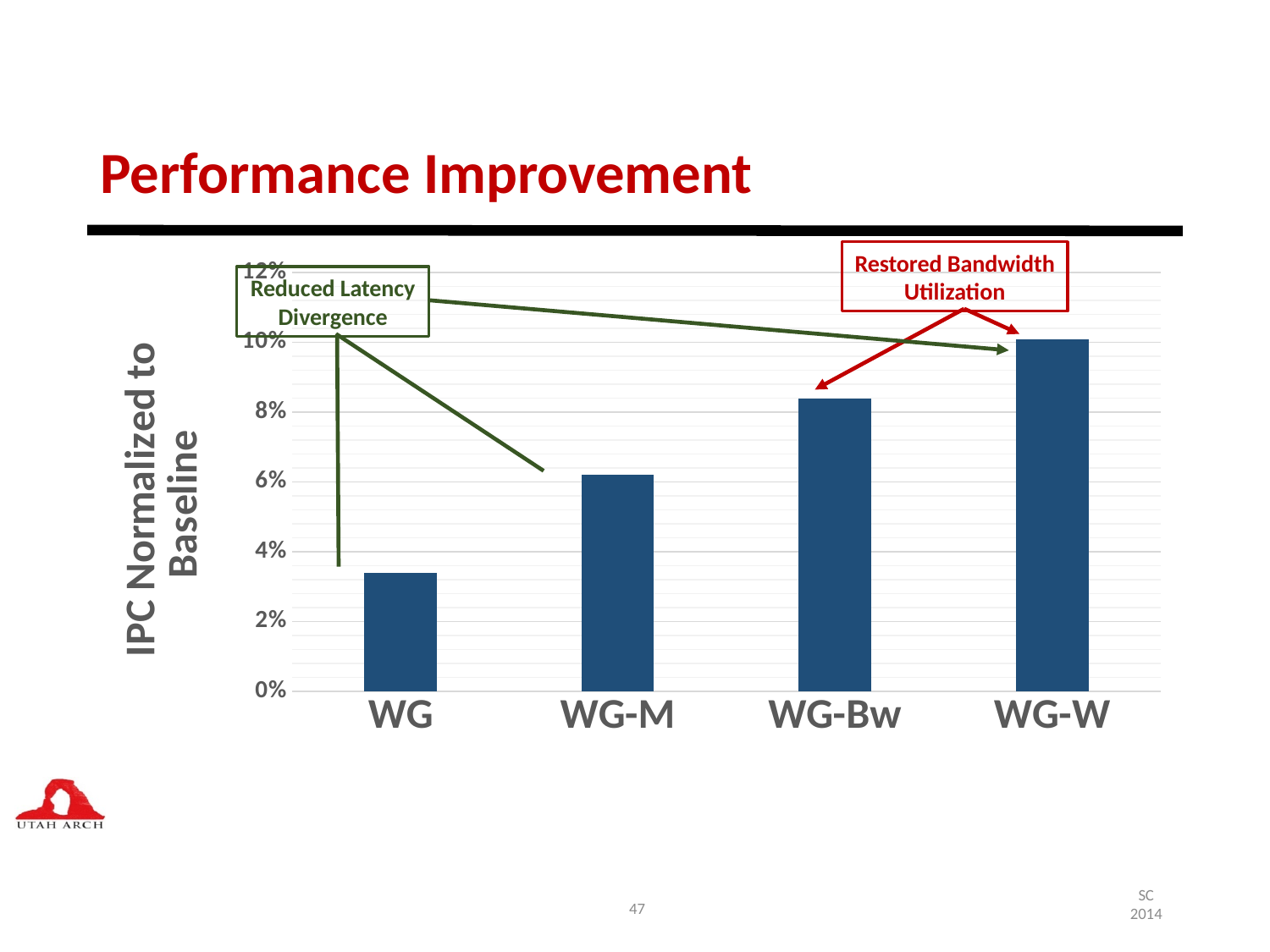
Is the value for WG-W greater or less than 8%? greater Is the value for WG-M greater or less than 8%? less Is the value for WG-Bw greater or less than 8%? greater Which has the larger value, WG or WG-W? WG-W What kind of chart is shown on the slide? bar chart Do the bar values rise or fall from WG to WG-W along the x axis? rise What is the label of the vertical axis? IPC Normalized to Baseline Which category has the highest IPC improvement? WG-W Which category has the lowest IPC improvement? WG How many categories are plotted on the x axis? 4 Which has the larger value, WG-M or WG-Bw? WG-Bw